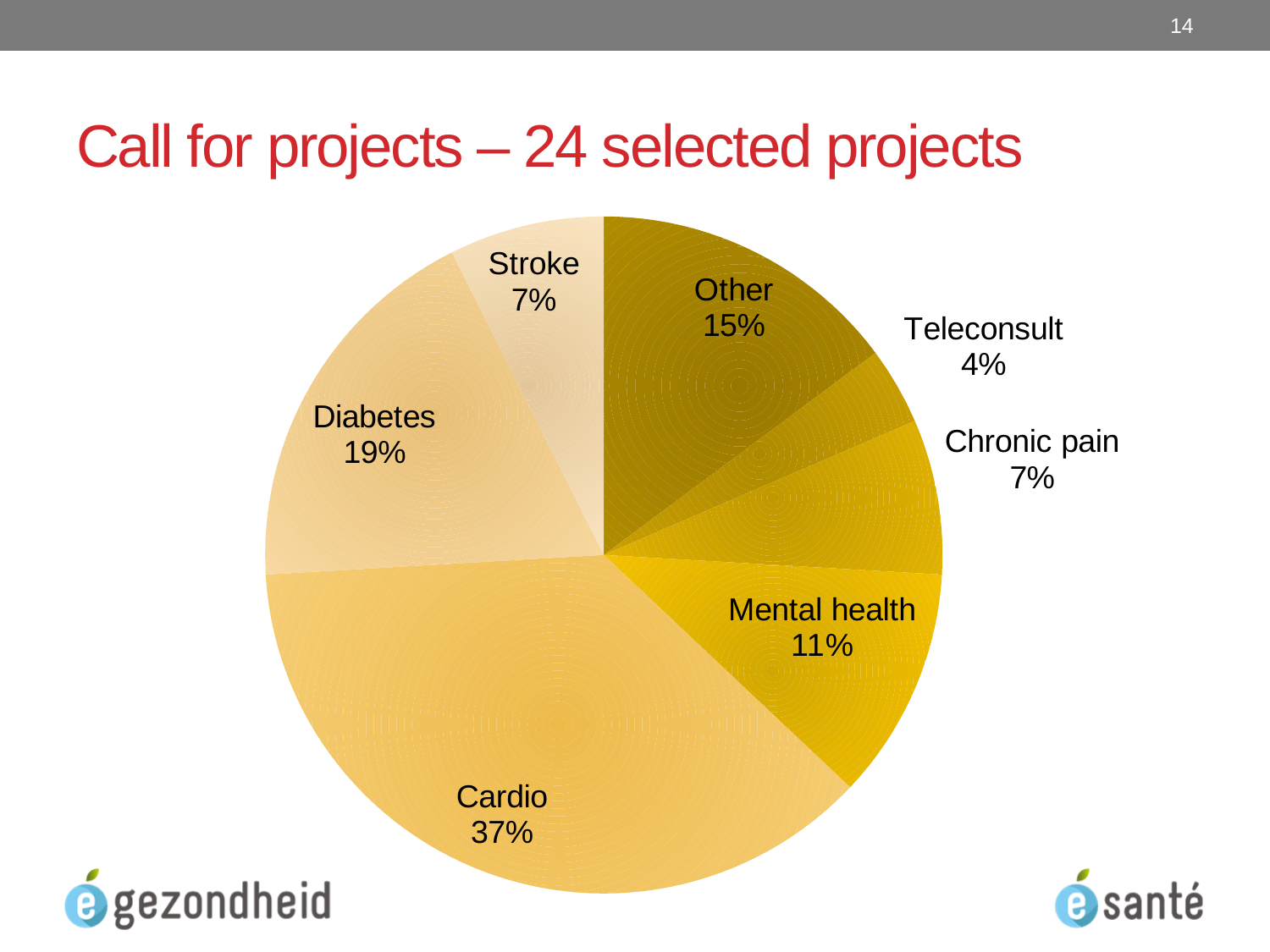
What is the difference between the Cardio and Diabetes shares? 18% Which is larger, the share for Other or the share for Mental health? Other What share of the pie does Cardio represent? 37% What is the value shown for Teleconsult? 4% What is the title of the slide containing the pie chart? Call for projects – 24 selected projects What is the value shown for Mental health? 11% Which category has the smallest slice of the pie? Teleconsult What is the combined share of Stroke and Chronic pain? 14% How many categories are shown in the pie chart? 7 What kind of chart is shown on the slide? pie chart Which category has the largest slice of the pie? Cardio What is the value shown for Diabetes? 19%